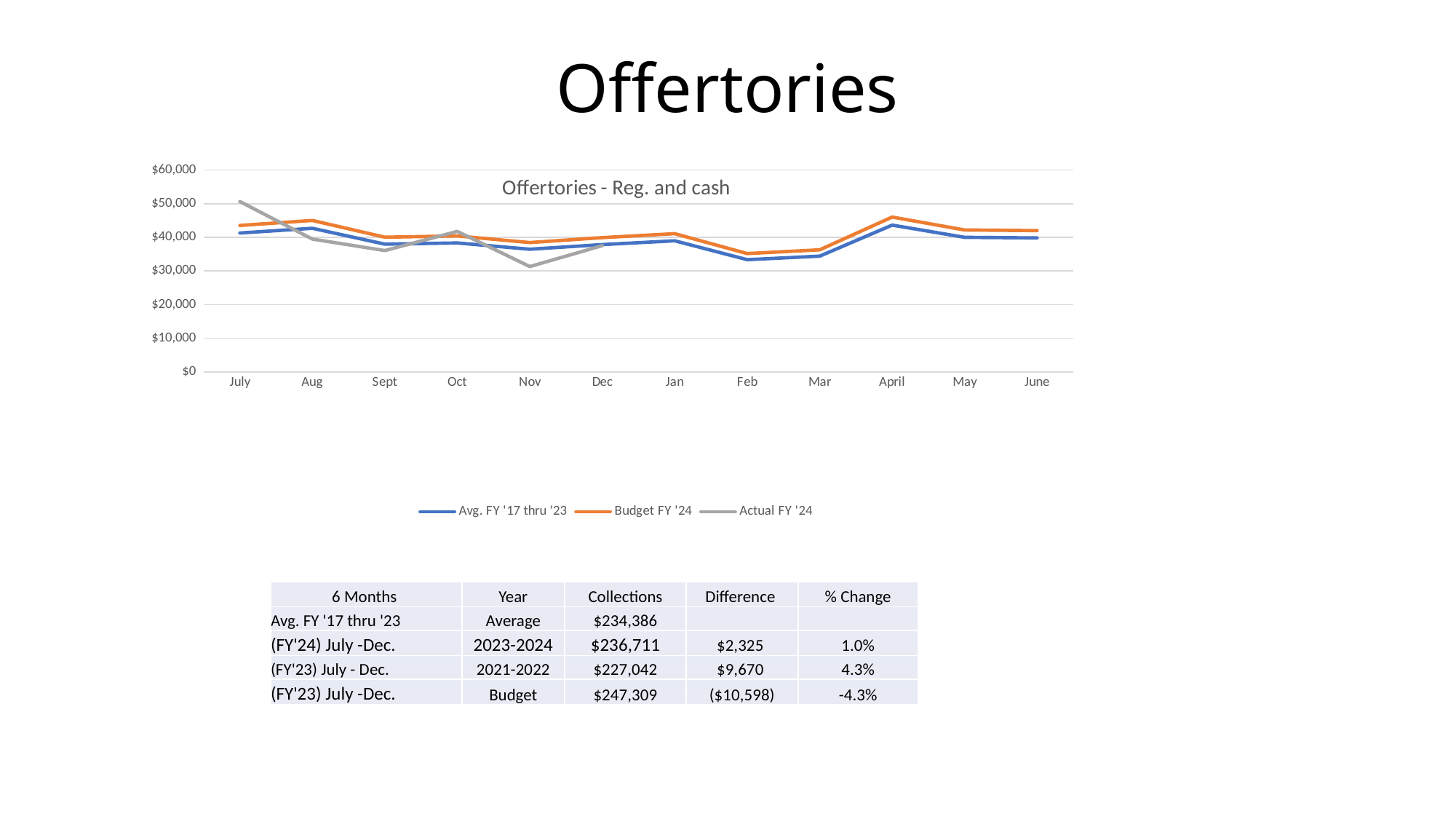
What is the title of the chart? Offertories - Reg. and cash How many series does the chart legend list? 3 In July, which is higher: Actual FY '24 or Budget FY '24? Actual FY '24 Is the value for Budget FY '24 in April greater or less than $40,000? greater Which series is drawn in gray on the chart? Actual FY '24 Does the Actual FY '24 line rise or fall from Nov to Dec? rise In which month is the Actual FY '24 line at its lowest? Nov How many months are shown along the x axis of the chart? 12 Is the value for Avg. FY '17 thru '23 in Feb greater or less than $40,000? less In which month is the Actual FY '24 line at its highest? July Is the value for Actual FY '24 in Nov greater or less than $40,000? less What kind of chart is shown on the slide? line chart